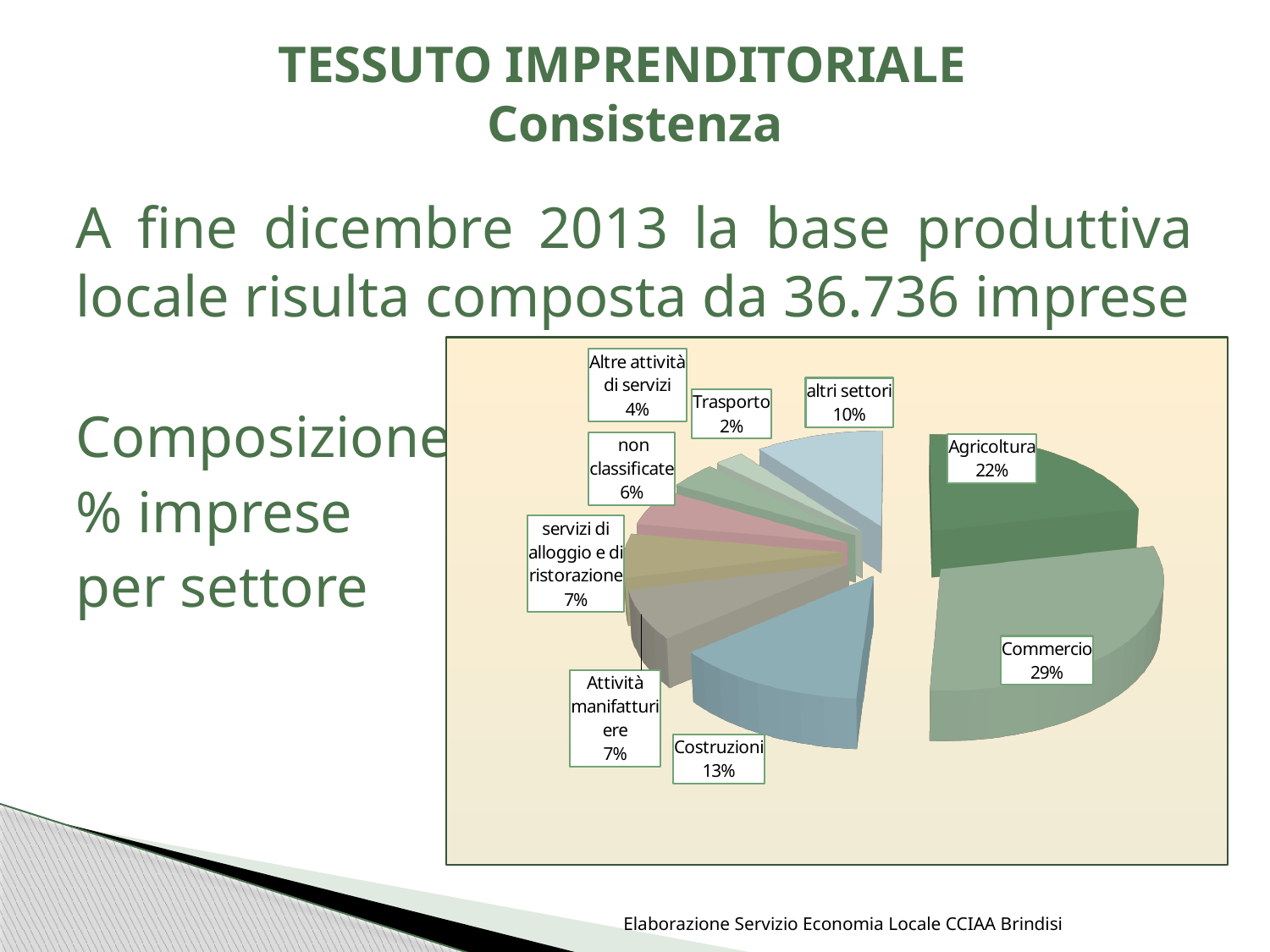
What share of the pie does Agricoltura hold? 22% What is the value shown for Costruzioni? 13% Which is larger, the share for Costruzioni or the share for altri settori? Costruzioni Which sector has the smallest slice of the pie? Trasporto What is the difference between the shares of altri settori and Altre attività di servizi? 6% What share of the pie does Commercio hold? 29% What is the value shown for non classificate? 6% What is the value shown for Trasporto? 2% What is the difference between the shares of Commercio and Agricoltura? 7% What kind of chart is shown on the slide? pie chart How many slices does the pie chart have? 9 Which sector has the largest slice of the pie? Commercio